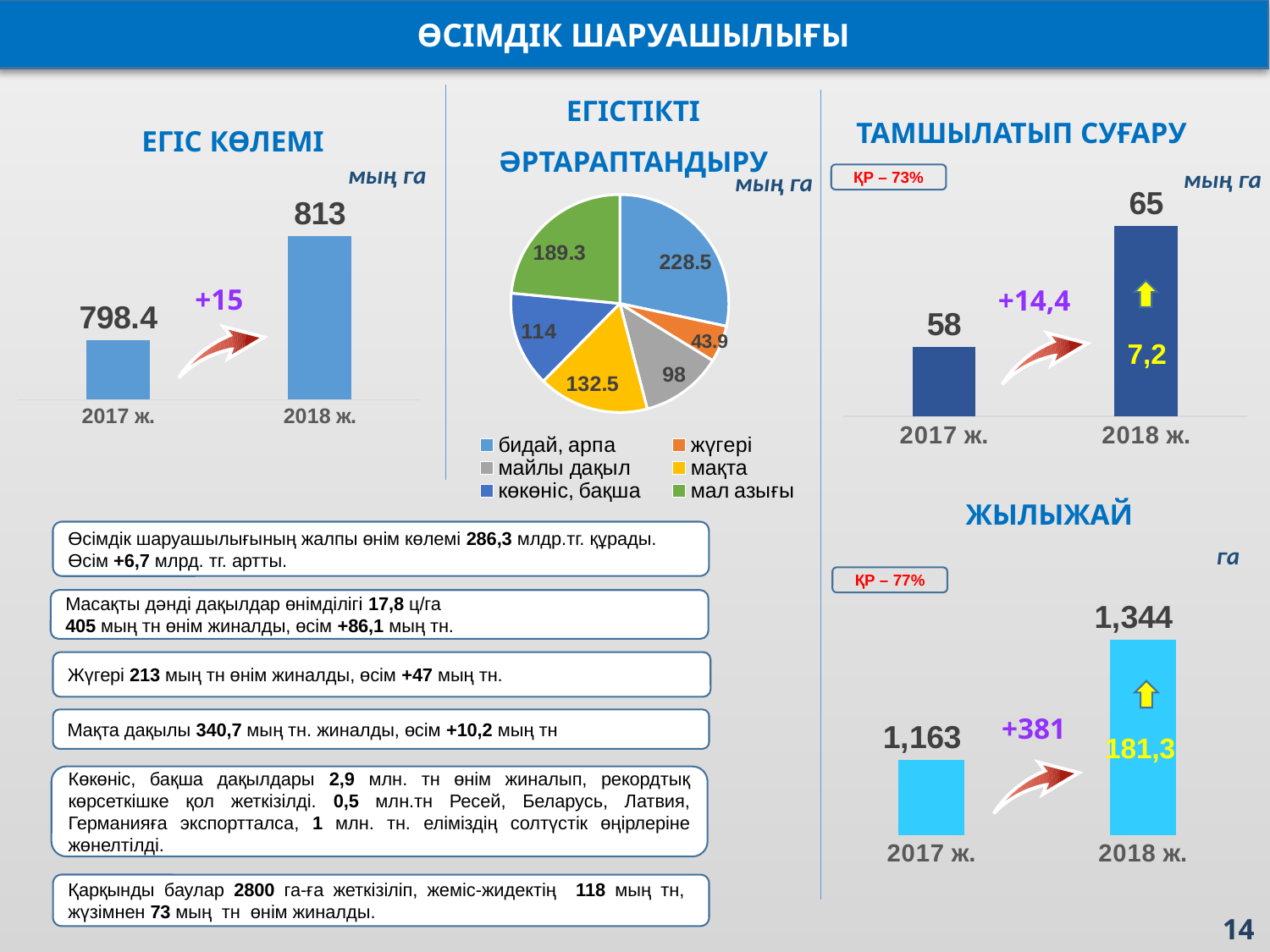
In the ЕГІС КӨЛЕМІ chart, what is the value for 2018 ж.? 813 In the ЕГІСТІКТІ ӘРТАРАПТАНДЫРУ pie chart, which category has the smallest value? жүгері In the ЖЫЛЫЖАЙ chart, do the values rise or fall from 2017 ж. to 2018 ж.? rise What kind of chart is the ЕГІСТІКТІ ӘРТАРАПТАНДЫРУ chart? pie chart In the ЕГІСТІКТІ ӘРТАРАПТАНДЫРУ pie chart, what is the difference between бидай, арпа and мал азығы? 39.2 In the ЕГІСТІКТІ ӘРТАРАПТАНДЫРУ pie chart, which category has the largest value? бидай, арпа In the ЖЫЛЫЖАЙ chart, what is the value for 2017 ж.? 1,163 In the ТАМШЫЛАТЫП СУҒАРУ chart, what is the difference between 2018 ж. and 2017 ж.? 7 In the ЕГІСТІКТІ ӘРТАРАПТАНДЫРУ pie chart, what is the value for мақта? 132.5 In the ЕГІС КӨЛЕМІ chart, what is the value for 2017 ж.? 798.4 How many categories does the legend of the ЕГІСТІКТІ ӘРТАРАПТАНДЫРУ pie chart list? 6 In the ТАМШЫЛАТЫП СУҒАРУ chart, what is the value for 2018 ж.? 65